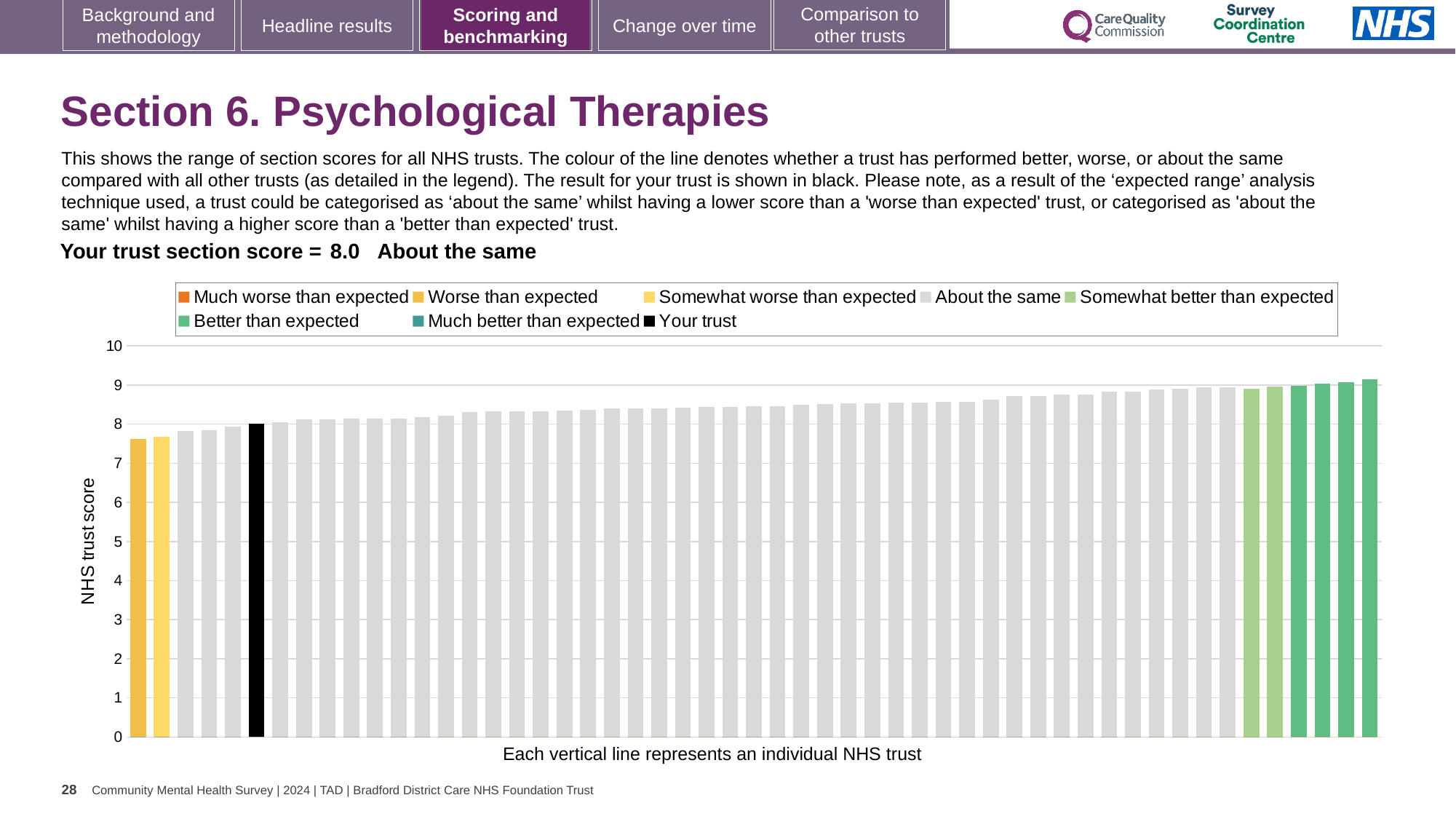
What kind of chart is shown on the slide? bar chart What is the label on the vertical axis of the chart? NHS trust score Is the leftmost bar higher or lower than the black 'Your trust' bar? lower Is the value of the black 'Your trust' bar greater or less than 9? less How many entries does the chart legend list? 8 What is the section score for your trust shown on the slide? 8.0 Which performance category is your trust placed in for this section? About the same What colour is the bar representing your trust? black How many bars in the chart are coloured yellow? 2 Is the value of the leftmost bar in the chart greater or less than 8? less Do the bar values rise or fall from left to right across the chart? rise Is the value of the tallest bar in the chart greater or less than 9? greater